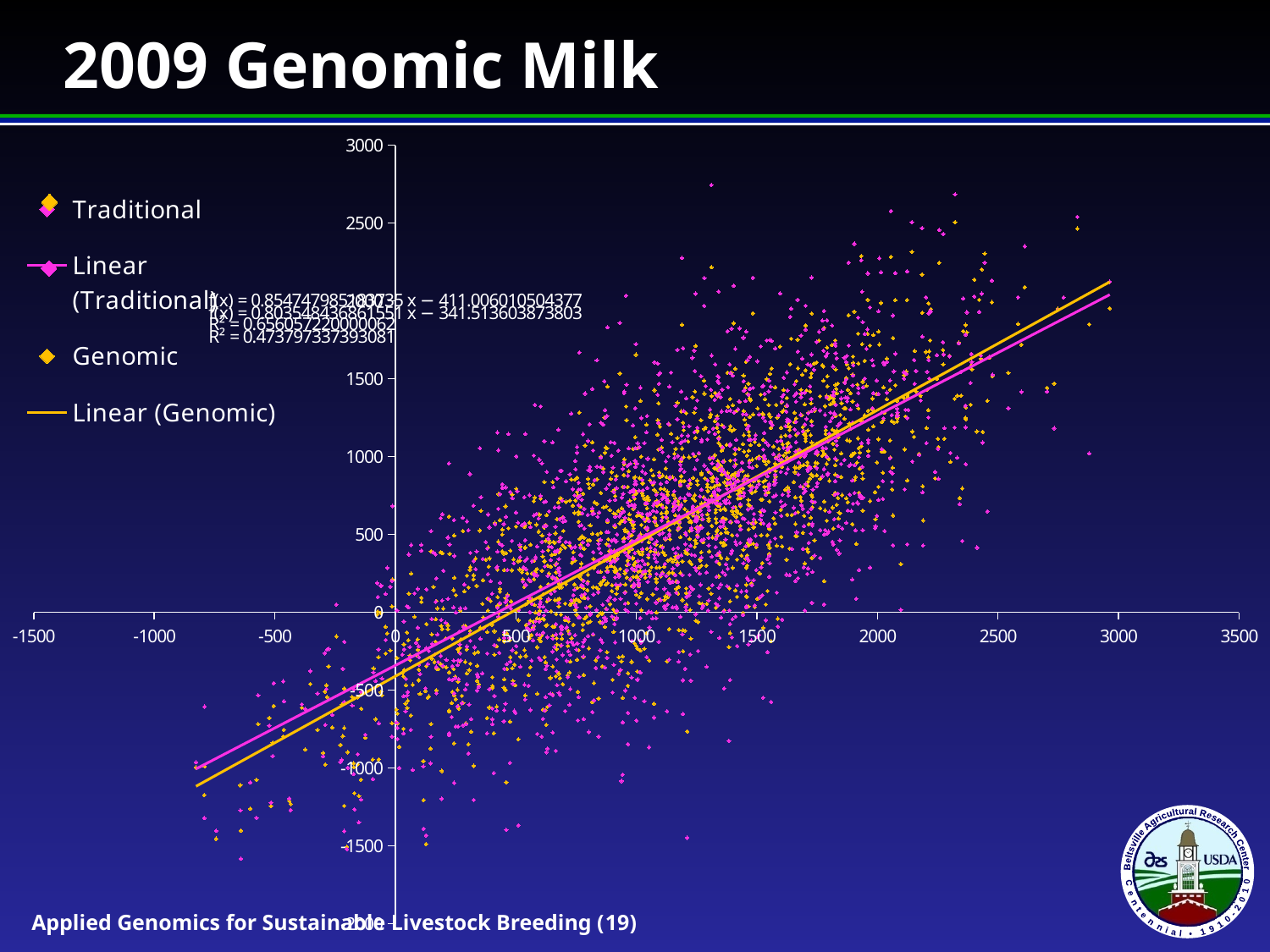
What is the title of the slide containing the chart? 2009 Genomic Milk What kind of chart is shown on the slide? scatter chart Do the plotted values generally rise or fall as the x-axis value increases? rise How many entries does the chart's legend list? 4 Which series is plotted with yellow diamond markers? Genomic